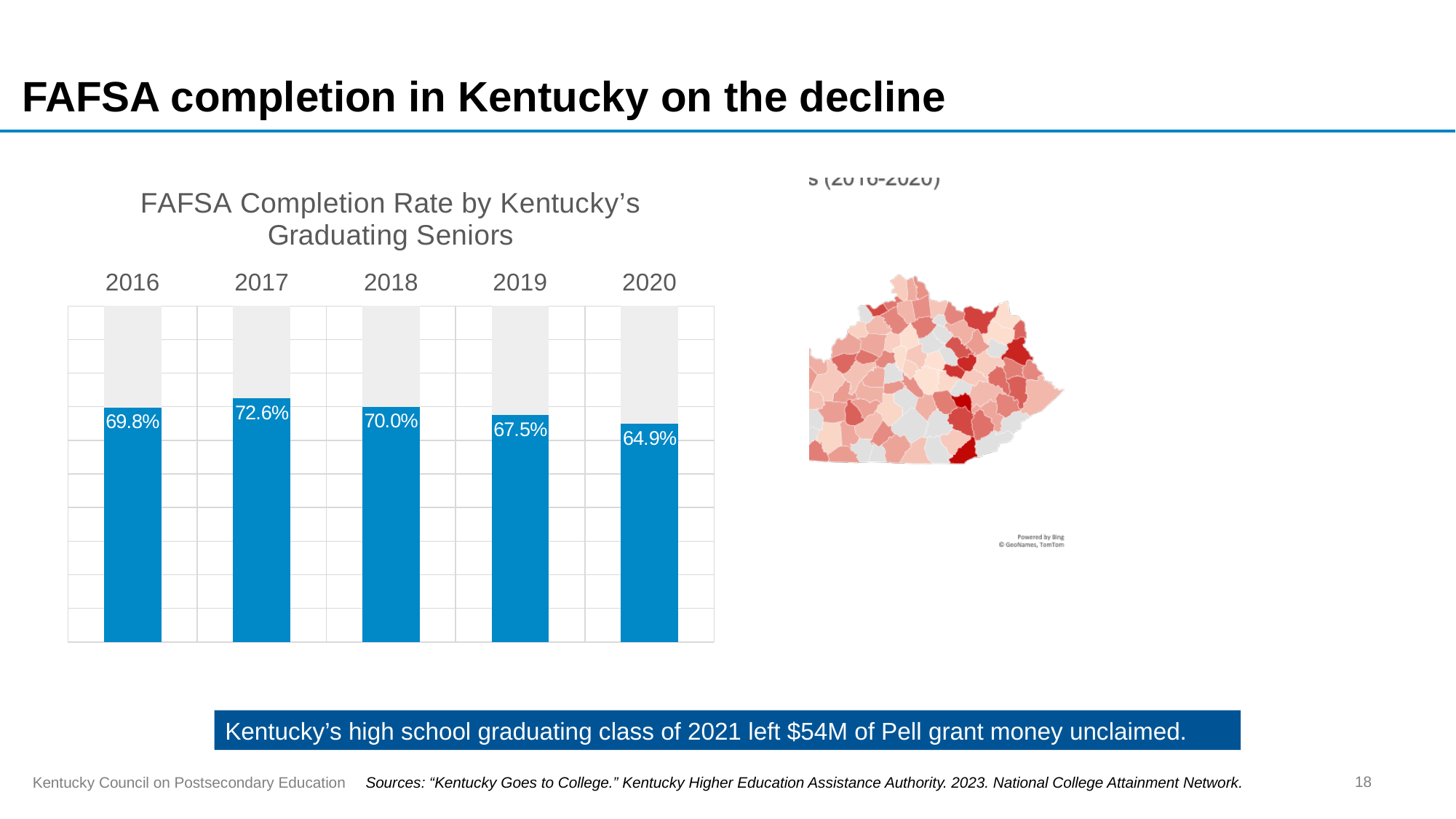
How many years are shown in the FAFSA completion rate chart? 5 What kind of chart is used to show the FAFSA completion rate? Bar chart Which year had the highest FAFSA completion rate? 2017 What is the title of the bar chart on the slide? FAFSA Completion Rate by Kentucky's Graduating Seniors Which year had a higher FAFSA completion rate, 2018 or 2019? 2018 What was the FAFSA completion rate in 2020? 64.9% What is the difference between the 2017 and 2020 FAFSA completion rates? 7.7% What was the FAFSA completion rate in 2017? 72.6% What is the difference between the 2018 and 2019 FAFSA completion rates? 2.5% What was the FAFSA completion rate for Kentucky's graduating seniors in 2016? 69.8% Which year had the lowest FAFSA completion rate? 2020 From 2017 to 2020, does the FAFSA completion rate rise or fall? Fall